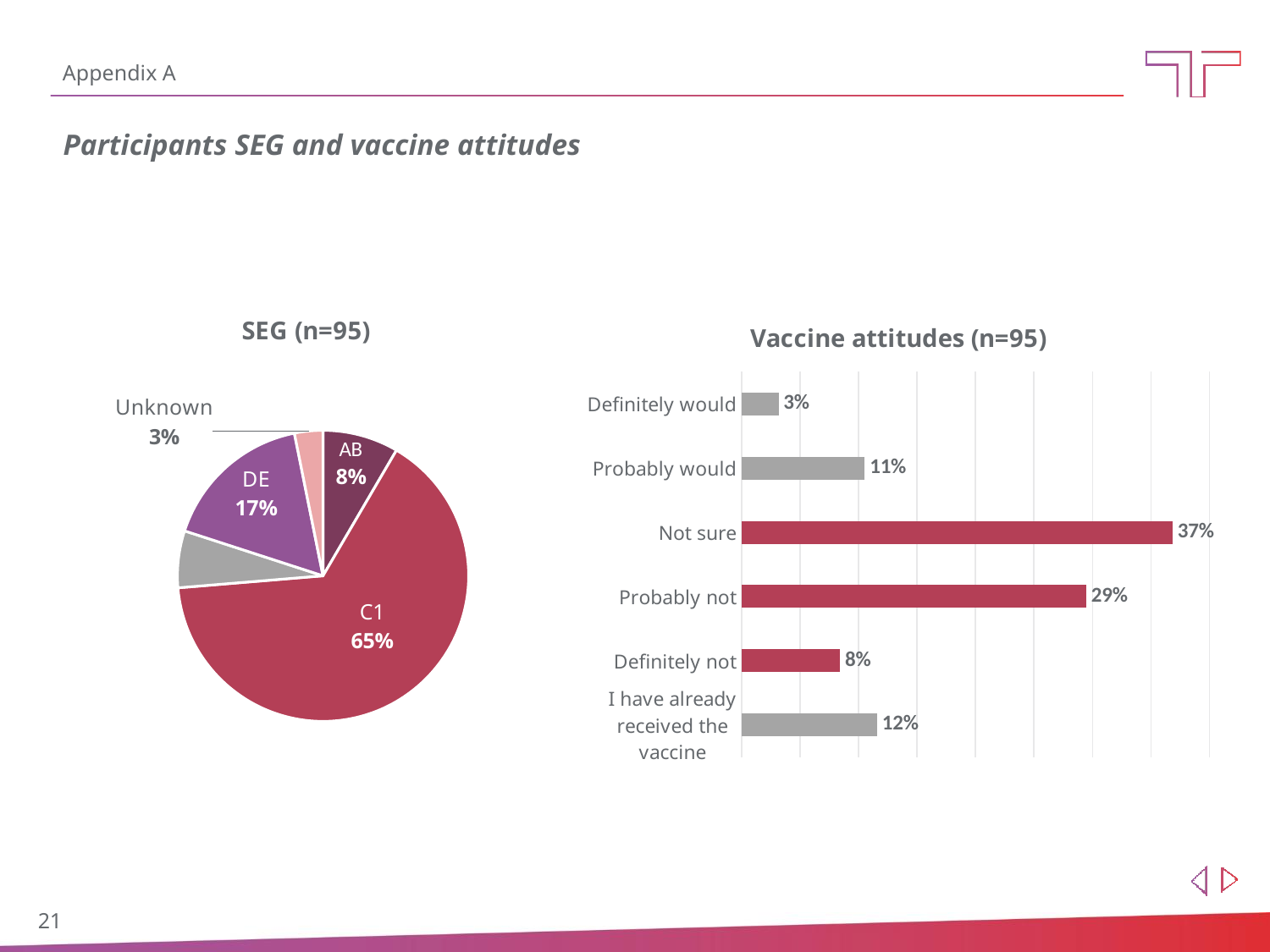
In the SEG (n=95) pie chart, what is the difference between the C1 share and the DE share? 48% In the SEG (n=95) pie chart, which labelled group has the largest share? C1 In the Vaccine attitudes (n=95) chart, what is the value for Not sure? 37% In the SEG (n=95) pie chart, what share of participants are in group AB? 8% In the SEG (n=95) pie chart, what share of participants are in group C1? 65% In the Vaccine attitudes (n=95) chart, which category has the lowest value? Definitely would How many categories are shown in the Vaccine attitudes (n=95) chart? 6 In the Vaccine attitudes (n=95) chart, what is the value for Probably not? 29% In the SEG (n=95) pie chart, what share of participants are in group DE? 17% In the Vaccine attitudes (n=95) chart, which is larger: Probably would or I have already received the vaccine? I have already received the vaccine What kind of chart is the Vaccine attitudes (n=95) chart? Bar chart In the Vaccine attitudes (n=95) chart, what is the difference between Not sure and Definitely not? 29%